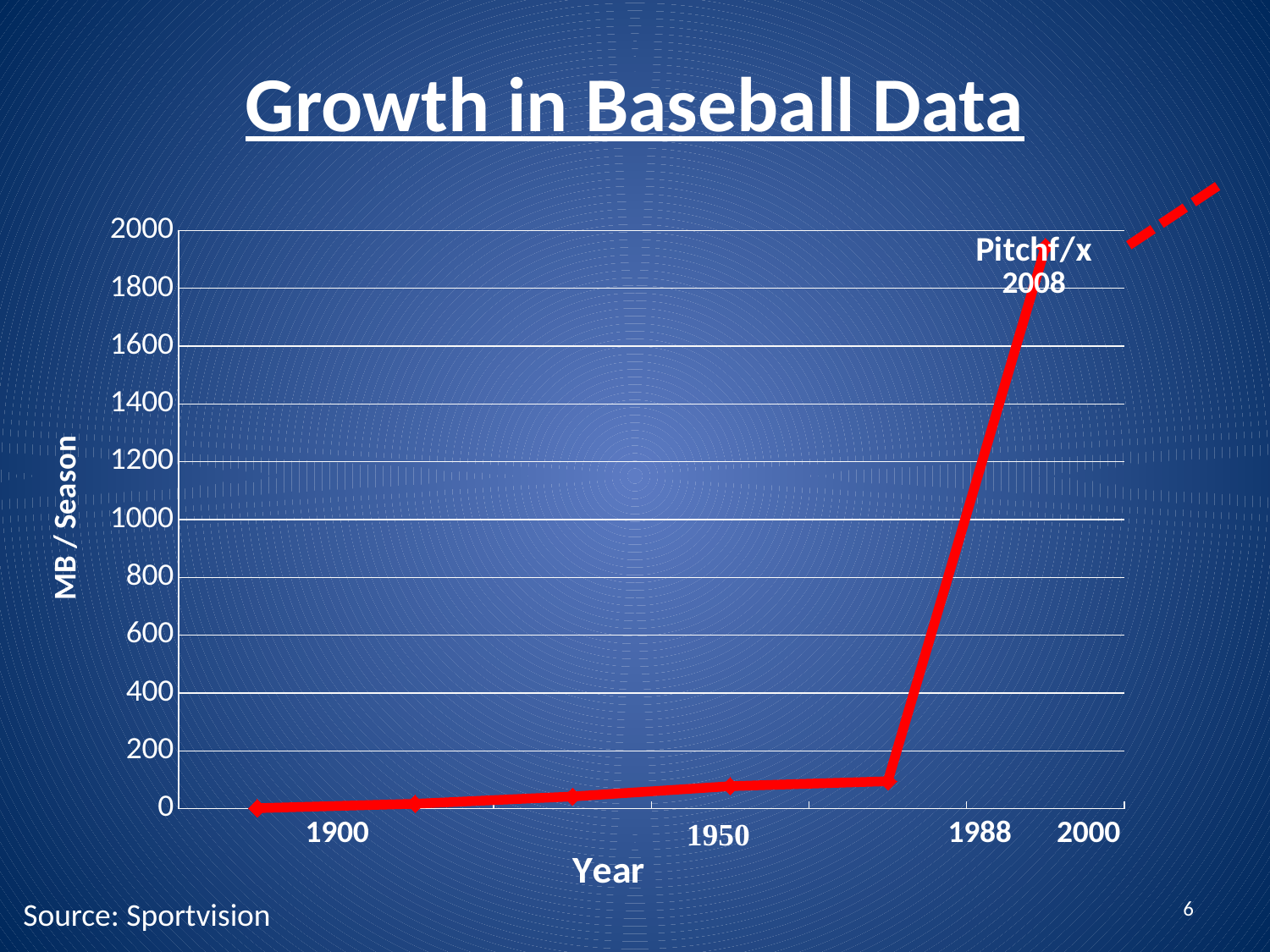
Which is larger, the value for 1950 or the value at the Pitchf/x 2008 point? Pitchf/x 2008 Is the value at the Pitchf/x 2008 point greater or less than 1800 MB / Season? greater Is the value at the Pitchf/x 2008 point greater or less than 1000 MB / Season? greater What is the highest tick value shown on the y axis? 2000 Is the value for 1900 greater or less than 200 MB / Season? less Do the values rise or fall as the year increases along the x axis? rise What is the label on the y axis of the chart? MB / Season What kind of chart is shown on the slide? line chart Which year shown has the highest MB / Season value? 2008 What is the title of the chart? Growth in Baseball Data